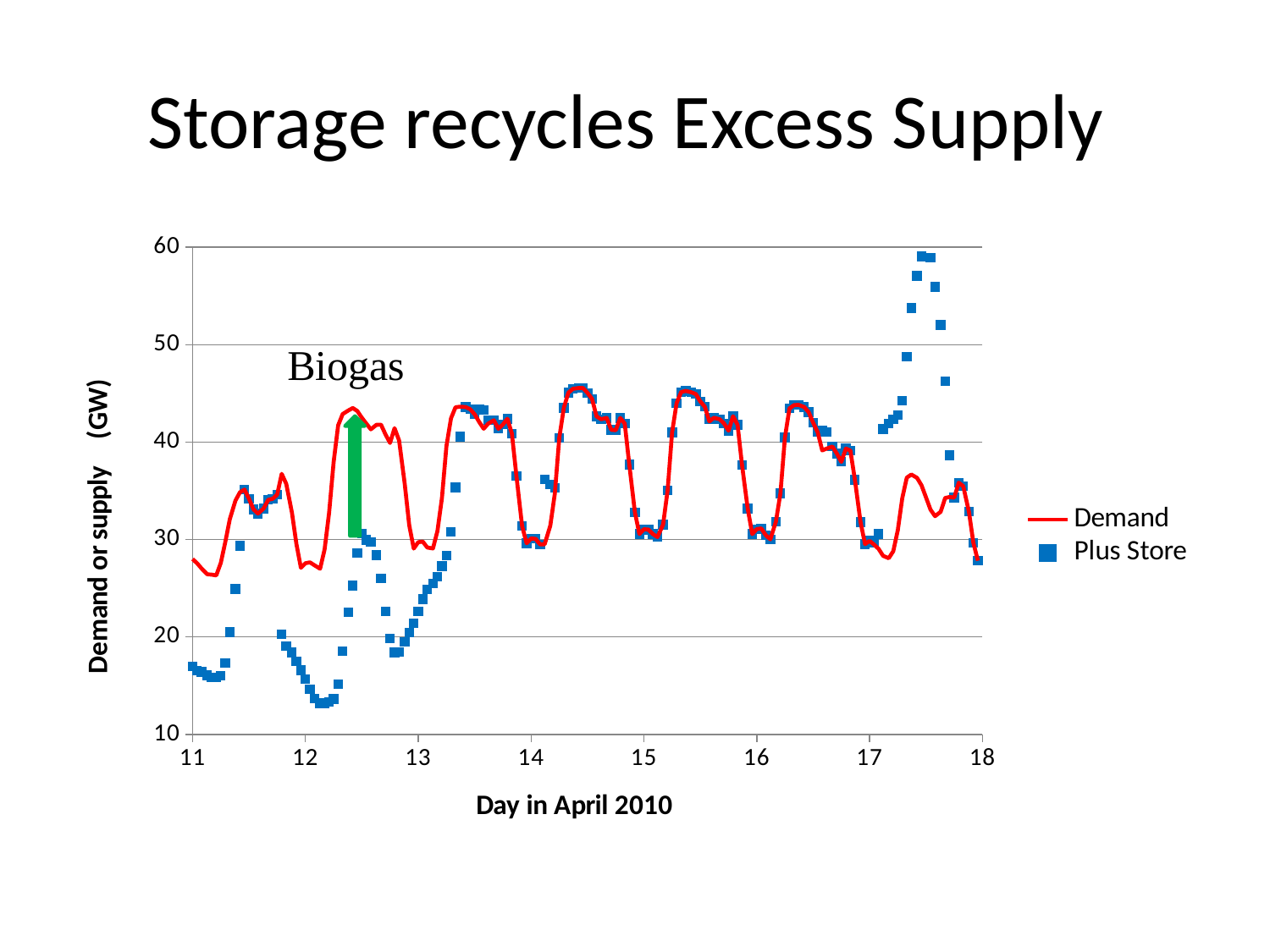
Does the Plus Store series rise or fall between day 17 and day 17.5? rise Which series reaches the highest value on the chart, Demand or Plus Store? Plus Store Is the peak Demand value near day 14.4 greater or less than 40? greater Is the Plus Store value at day 11 greater or less than 20? less What kind of chart is shown on the slide? Line chart with scatter points Is the Demand value at day 11 greater or less than 30? less What is the title of the slide's chart? Storage recycles Excess Supply What label is written next to the green arrow on the chart? Biogas How many series does the legend list? 2 Does the Demand line rise or fall between day 13 and day 13.4? rise